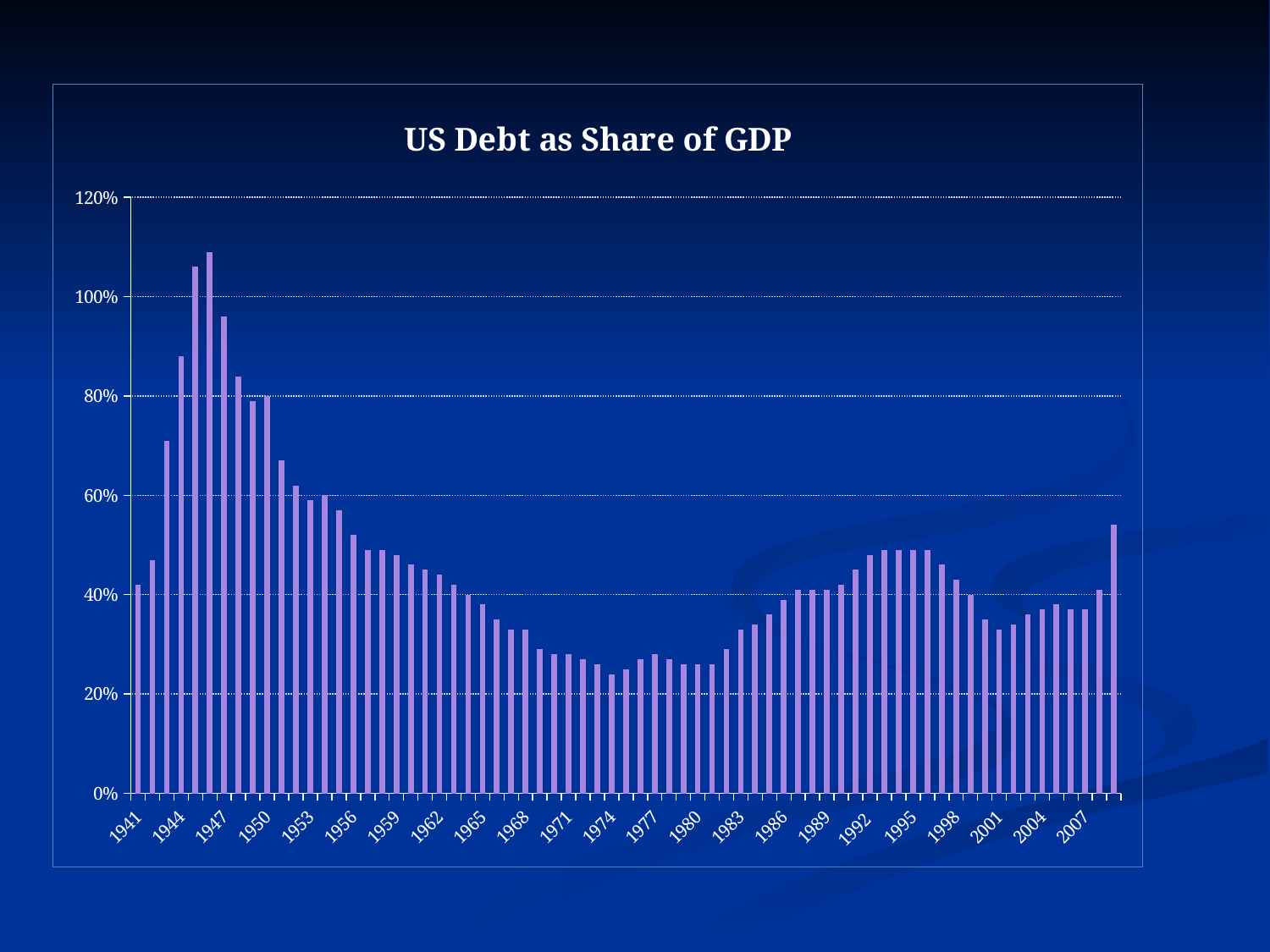
What kind of chart is shown on the slide? bar chart Is the value for 1971 greater or less than 20%? greater Is the value for 1992 greater or less than 40%? greater What is the title of the chart? US Debt as Share of GDP Is the value for 2001 greater or less than 40%? less Which year has the larger value, 1944 or 1980? 1944 Do the values generally rise or fall from 1947 to 1974? fall What is the highest value shown on the vertical axis? 120%